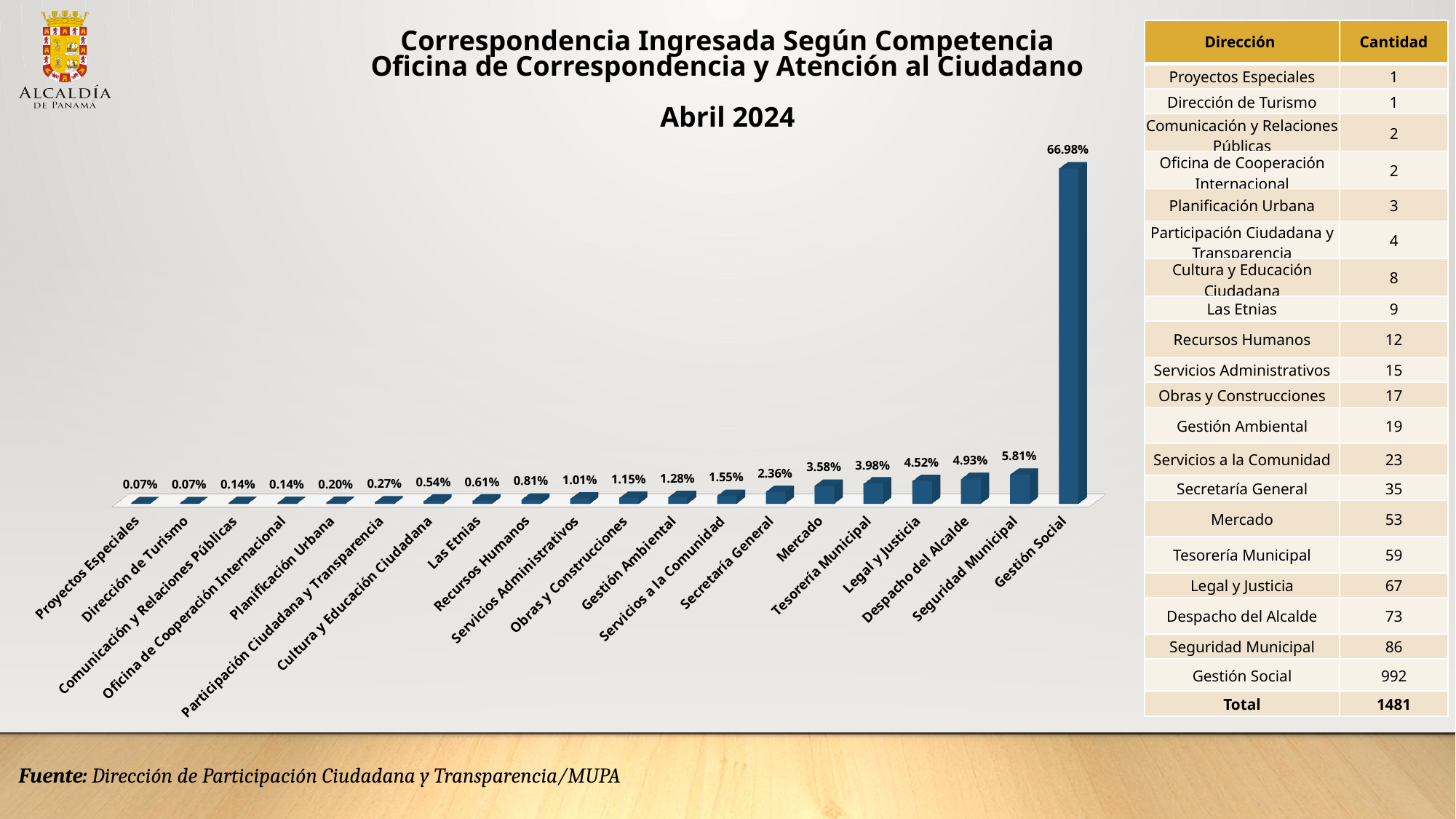
What is the difference between the values for Gestión Social and Seguridad Municipal in the chart? 61.17% Do the values in the chart rise or fall from left to right along the x axis? rise What kind of chart is shown on the slide? bar chart What month and year does the chart title refer to? Abril 2024 What is the value shown for Secretaría General in the chart? 2.36% Which category has the highest value in the chart? Gestión Social What is the difference between the values for Despacho del Alcalde and Legal y Justicia in the chart? 0.41% What is the value shown for Las Etnias in the chart? 0.61% How many categories are plotted in the chart? 20 Which is larger in the chart, Mercado or Tesorería Municipal? Tesorería Municipal What is the value shown for Seguridad Municipal in the chart? 5.81% What is the value shown for Gestión Social in the chart? 66.98%